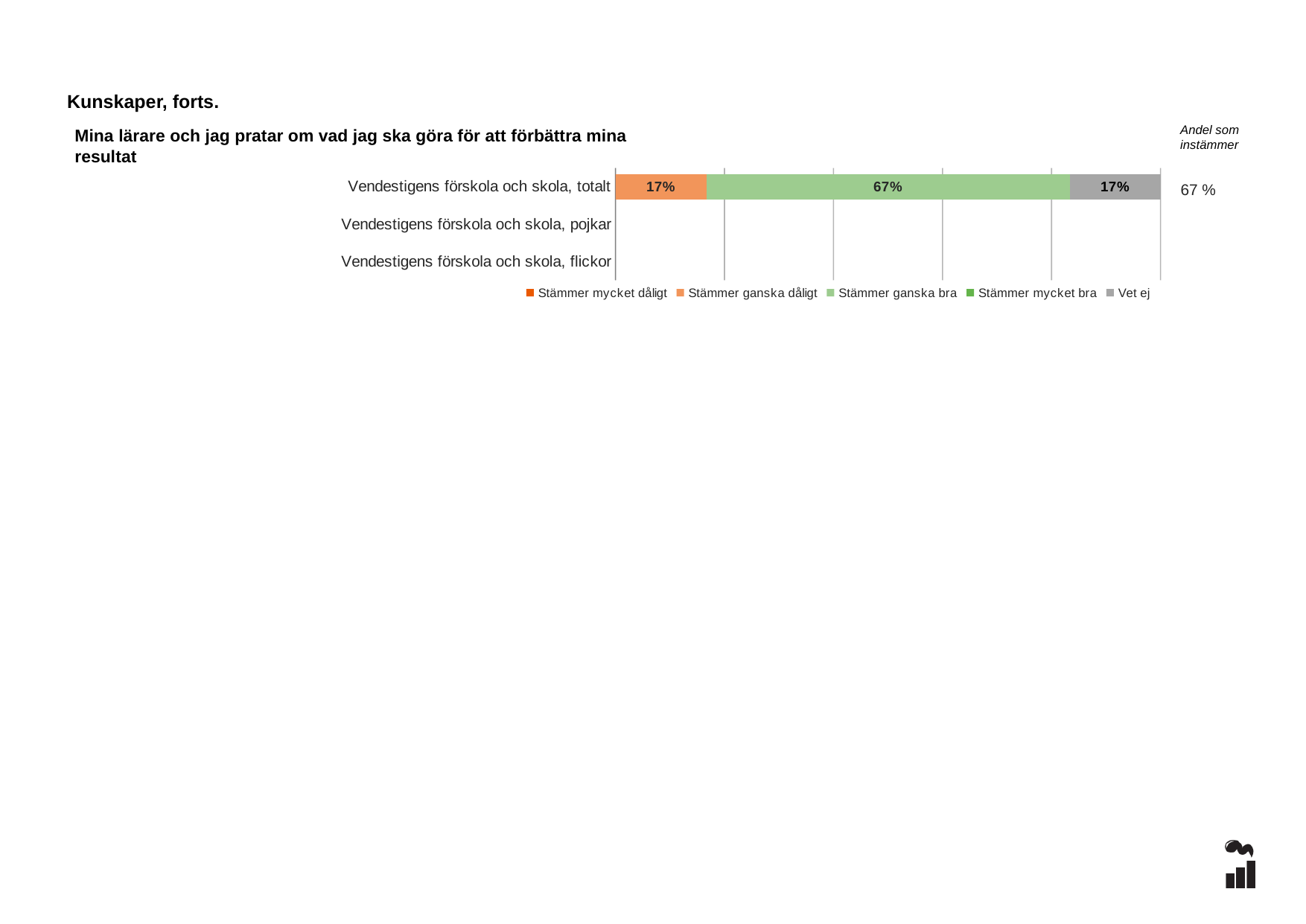
Which is larger for Vendestigens förskola och skola, totalt: the "Stämmer ganska bra" segment or the "Stämmer ganska dåligt" segment? Stämmer ganska bra Which segment is the largest in the bar for Vendestigens förskola och skola, totalt? Stämmer ganska bra What is the value for "Stämmer ganska bra" for Vendestigens förskola och skola, totalt? 67% What is the value for "Stämmer ganska dåligt" for Vendestigens förskola och skola, totalt? 17% What is the difference between the "Stämmer ganska bra" value and the "Vet ej" value for Vendestigens förskola och skola, totalt? 50 percentage points What is the title of the chart? Mina lärare och jag pratar om vad jag ska göra för att förbättra mina resultat What is the "Andel som instämmer" value shown to the right of the bar for Vendestigens förskola och skola, totalt? 67 % How many series does the legend list? 5 How many categories are listed on the vertical axis of the chart? 3 Which legend entry is shown in grey? Vet ej What kind of chart is shown on the slide? bar chart What is the value for "Vet ej" for Vendestigens förskola och skola, totalt? 17%